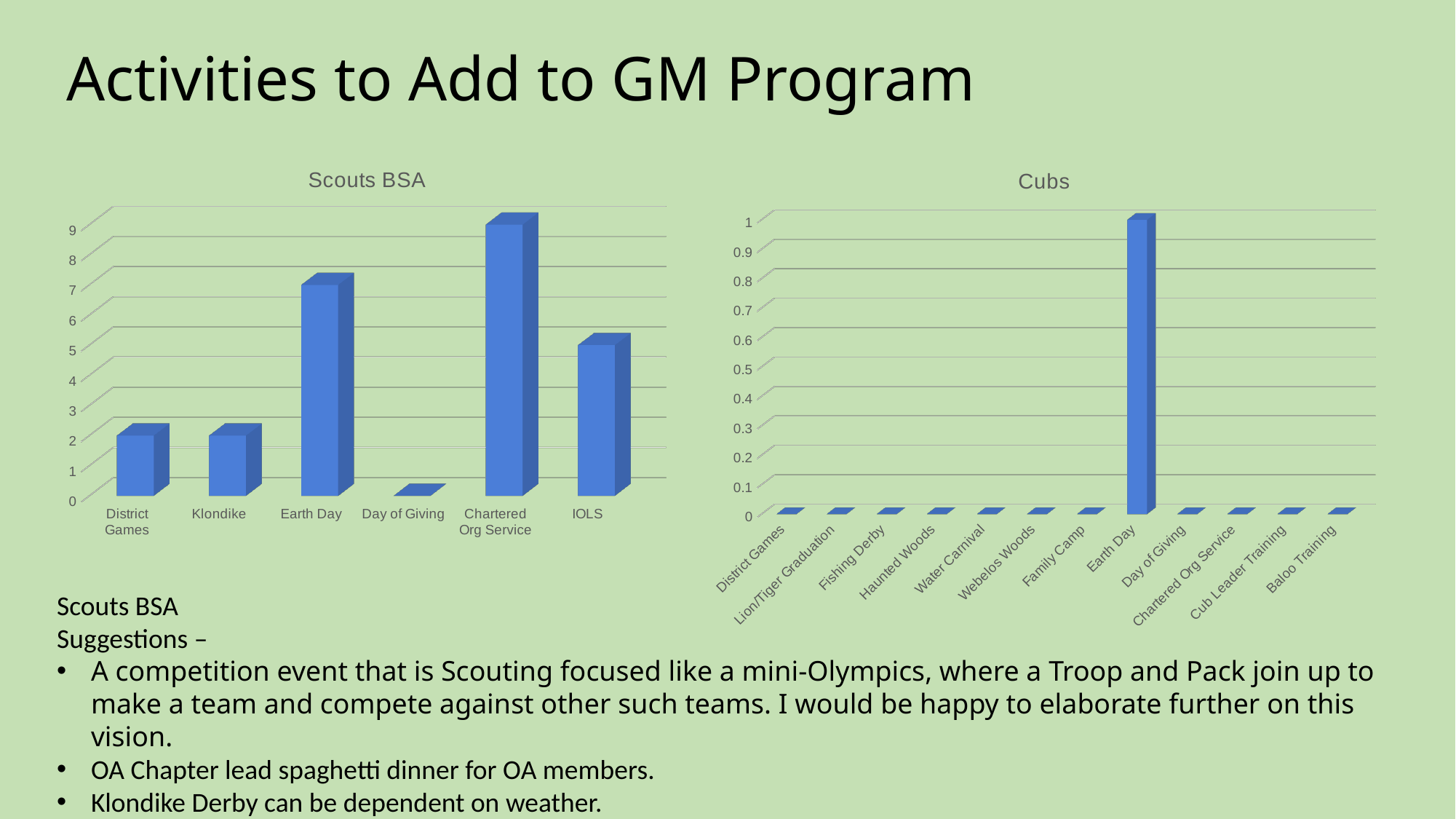
On the Scouts BSA chart, what is the value for Day of Giving? 0 On the Cubs chart, what is the value for Earth Day? 1 On the Scouts BSA chart, which category has the highest value? Chartered Org Service On the Scouts BSA chart, is the value for Earth Day greater or less than 5? greater What is the title of the chart on the right side of the slide? Cubs What kind of chart is the Scouts BSA chart? bar chart How many categories are shown on the Cubs chart? 12 How many categories are shown on the Scouts BSA chart? 6 On the Scouts BSA chart, which category has the lowest value? Day of Giving On the Scouts BSA chart, is the value for Klondike greater or less than 4? less On the Scouts BSA chart, which is larger, the value for IOLS or the value for District Games? IOLS On the Cubs chart, which category has the highest value? Earth Day